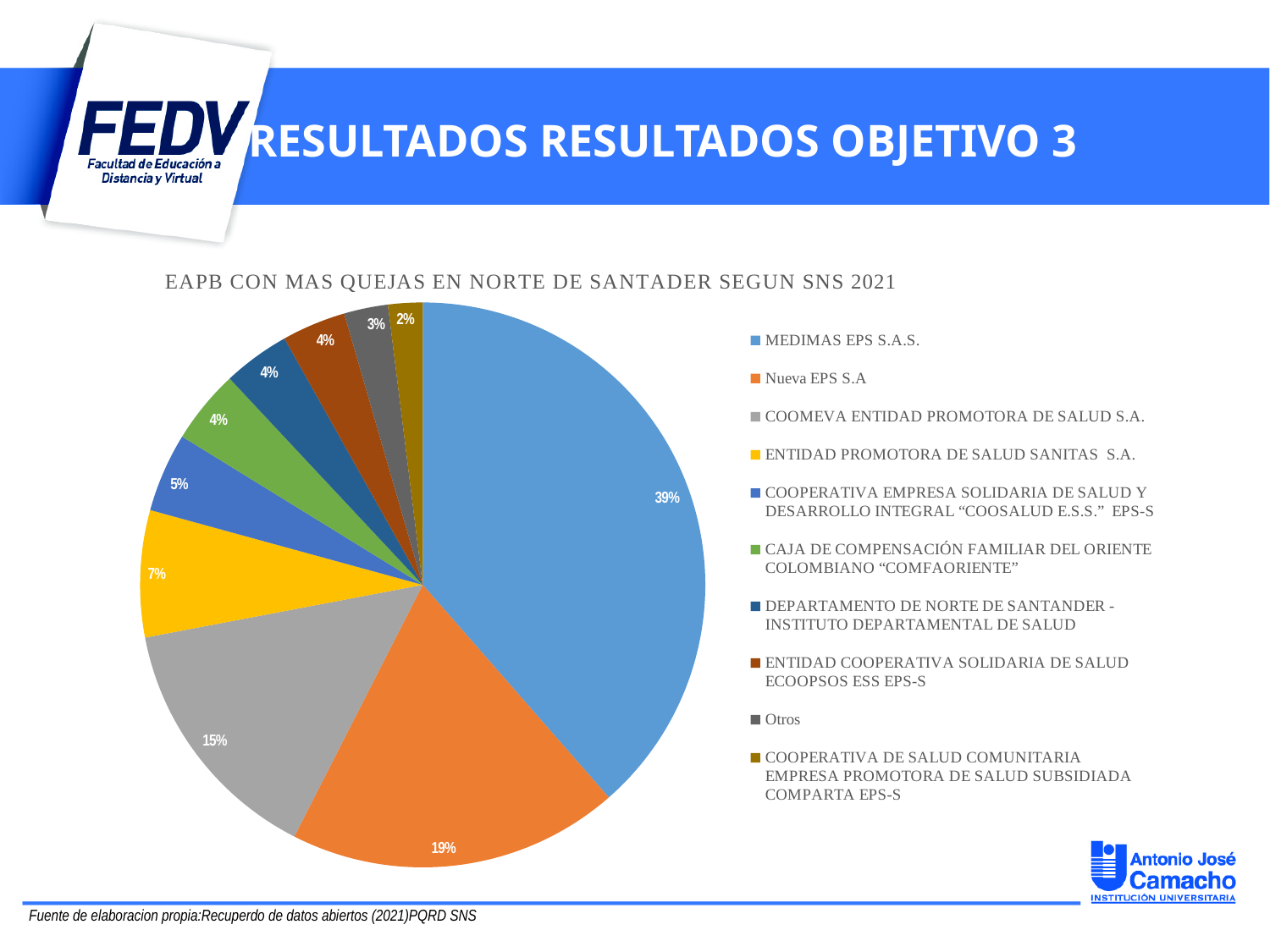
What is the title of the chart? EAPB CON MAS QUEJAS EN NORTE DE SANTADER SEGUN SNS 2021 What is the difference in percentage points between the MEDIMAS EPS S.A.S. slice and the Nueva EPS S.A slice? 20 percentage points Which is larger, the slice for COOMEVA ENTIDAD PROMOTORA DE SALUD S.A. or the slice for ENTIDAD PROMOTORA DE SALUD SANITAS S.A.? COOMEVA ENTIDAD PROMOTORA DE SALUD S.A. How many categories does the legend list? 10 What share of the pie does COOMEVA ENTIDAD PROMOTORA DE SALUD S.A. have? 15% What kind of chart is shown on the slide? Pie chart What share of the pie does ENTIDAD PROMOTORA DE SALUD SANITAS S.A. have? 7% Which category has the smallest slice of the pie? COOPERATIVA DE SALUD COMUNITARIA EMPRESA PROMOTORA DE SALUD SUBSIDIADA COMPARTA EPS-S What share of the pie does Nueva EPS S.A have? 19% Which category has the largest slice of the pie? MEDIMAS EPS S.A.S. What share of the pie does MEDIMAS EPS S.A.S. have? 39% What share of the pie does the Otros slice have? 3%